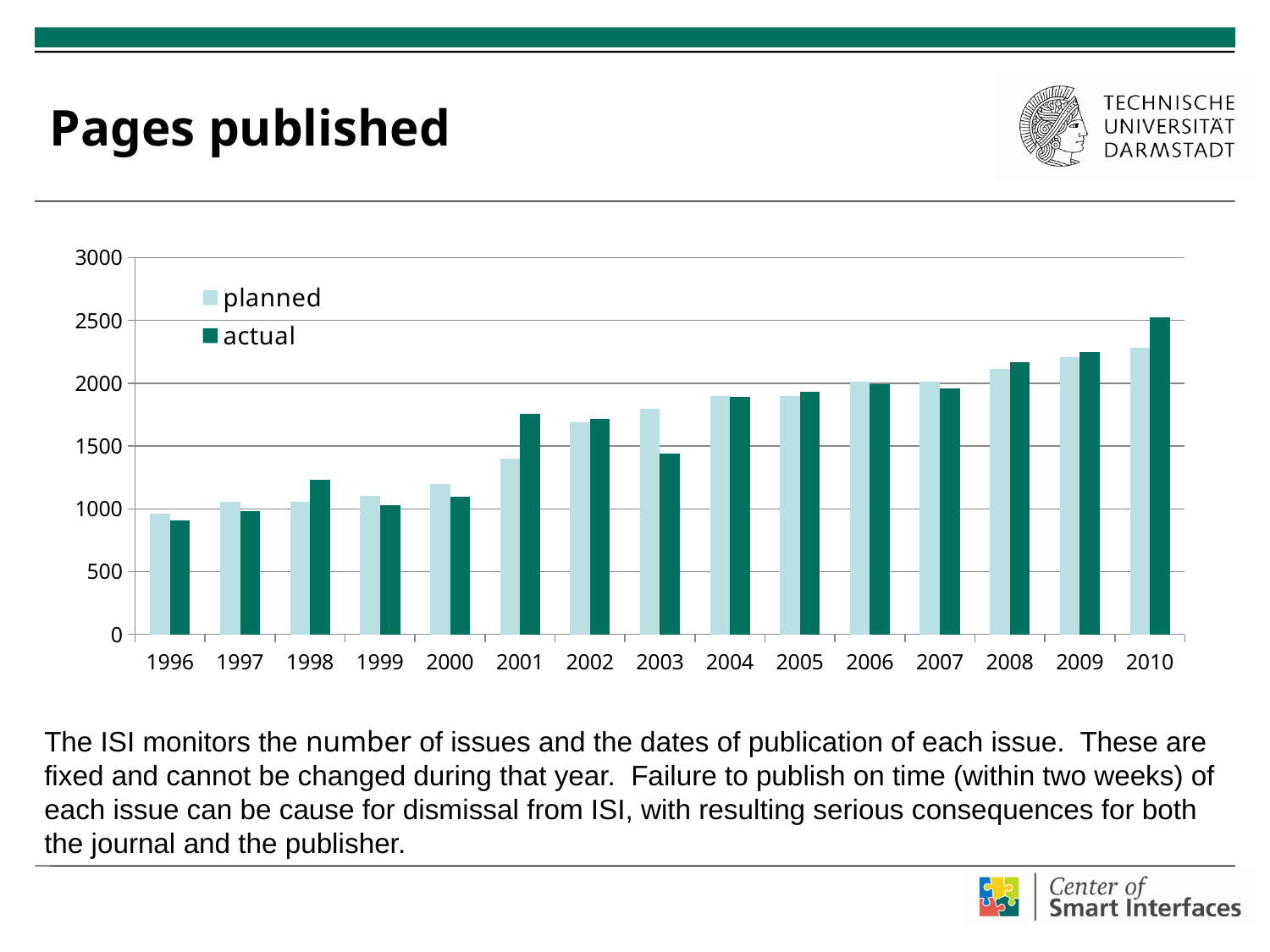
Is the planned value for 1996 greater or less than 1000? less Do the planned values generally rise or fall from 1996 to 2010? rise Which year has the highest actual value? 2010 In 2001, which is larger, the planned or the actual value? actual Is the actual value for 2001 greater or less than 1500? greater Which year has the lowest actual value? 1996 What are the two entries in the chart legend? planned and actual In 2003, which is larger, the planned or the actual value? planned Is the actual value for 2003 greater or less than 1500? less What kind of chart is shown on the slide? bar chart How many years are shown on the x axis? 15 How many series does the legend list? 2